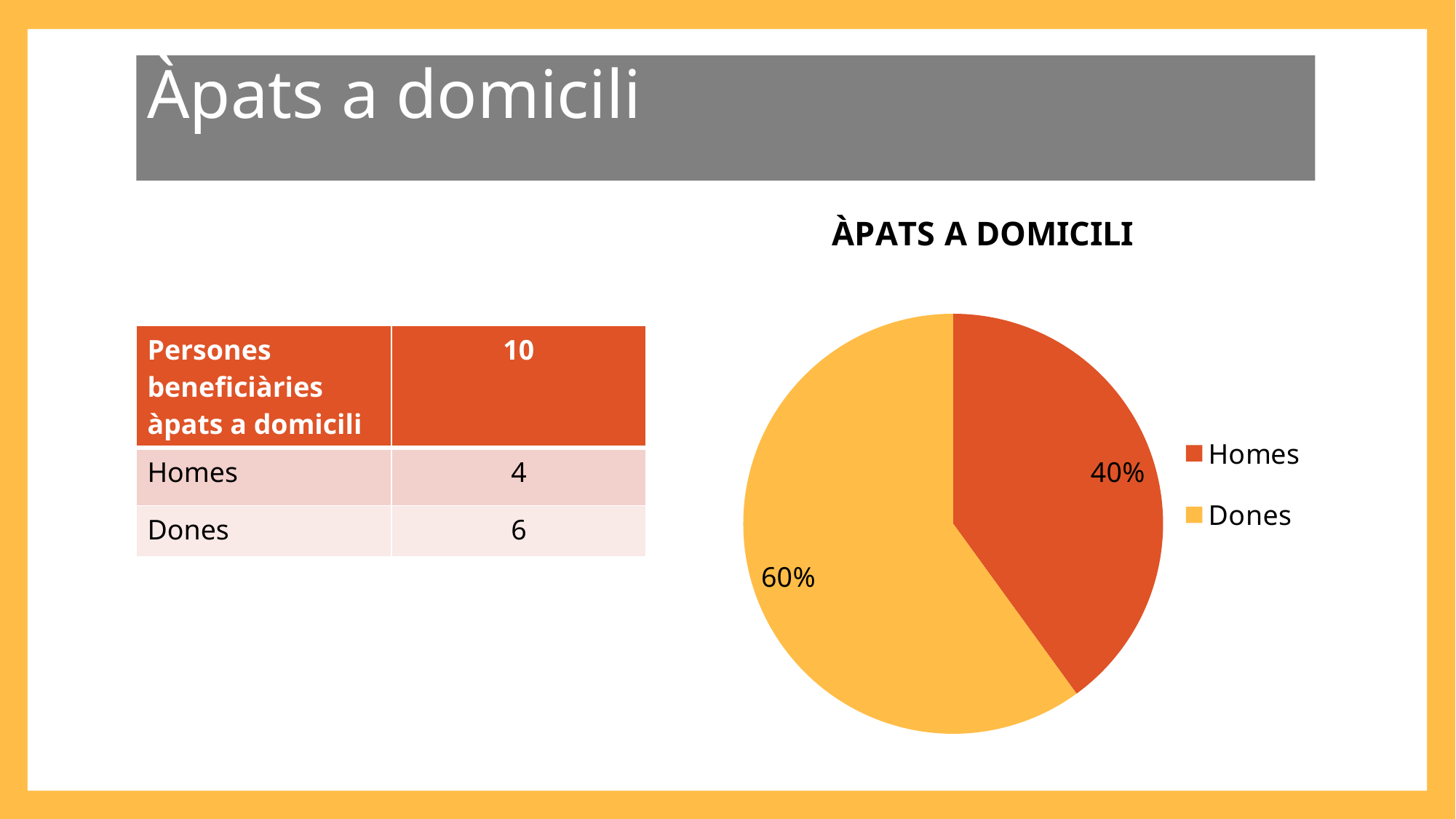
What is the title of the chart? ÀPATS A DOMICILI Which slice of the pie is the smallest? Homes What share of the pie does Homes represent? 40% How many slices does the pie chart have? 2 How many entries does the legend list? 2 What colour is the Dones slice in the pie chart? yellow What share of the pie does Dones represent? 60% Which slice of the pie is the largest? Dones What is the difference in percentage points between the Dones slice and the Homes slice? 20% What kind of chart is shown on the slide? pie chart Which is larger, the Homes slice or the Dones slice? Dones